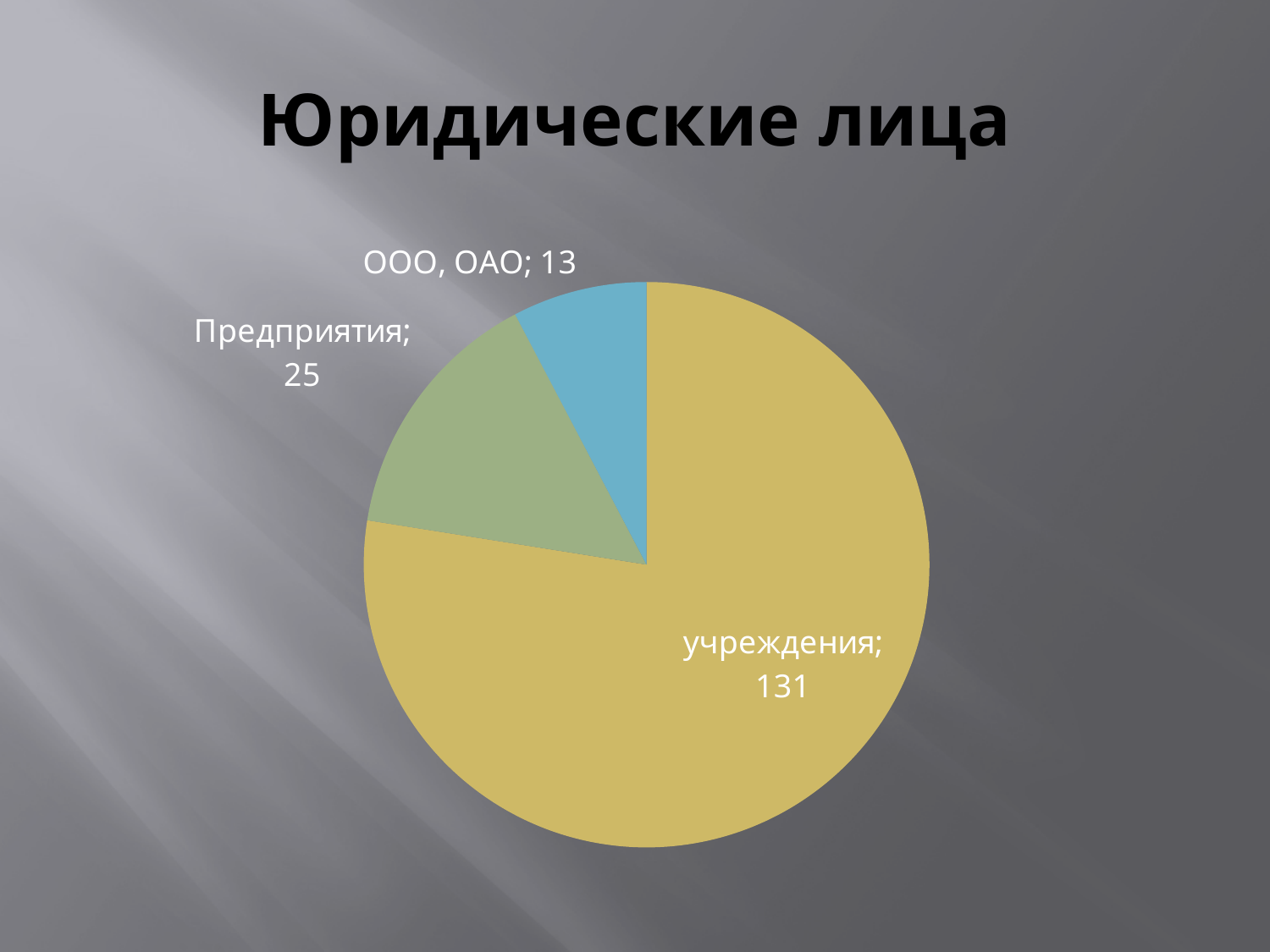
What is the total of all slices in the pie chart? 169 What is the value for учреждения in the pie chart? 131 How many categories are shown in the pie chart? 3 Which is larger, the value for Предприятия or the value for ООО, ОАО? Предприятия What is the difference between the values for Предприятия and ООО, ОАО? 12 What is the value for Предприятия in the pie chart? 25 What is the value for ООО, ОАО in the pie chart? 13 What kind of chart is shown on the slide? pie chart Which category has the smallest slice in the pie chart? ООО, ОАО What is the difference between the values for учреждения and Предприятия? 106 What is the title of the slide containing the pie chart? Юридические лица Which category has the largest slice in the pie chart? учреждения